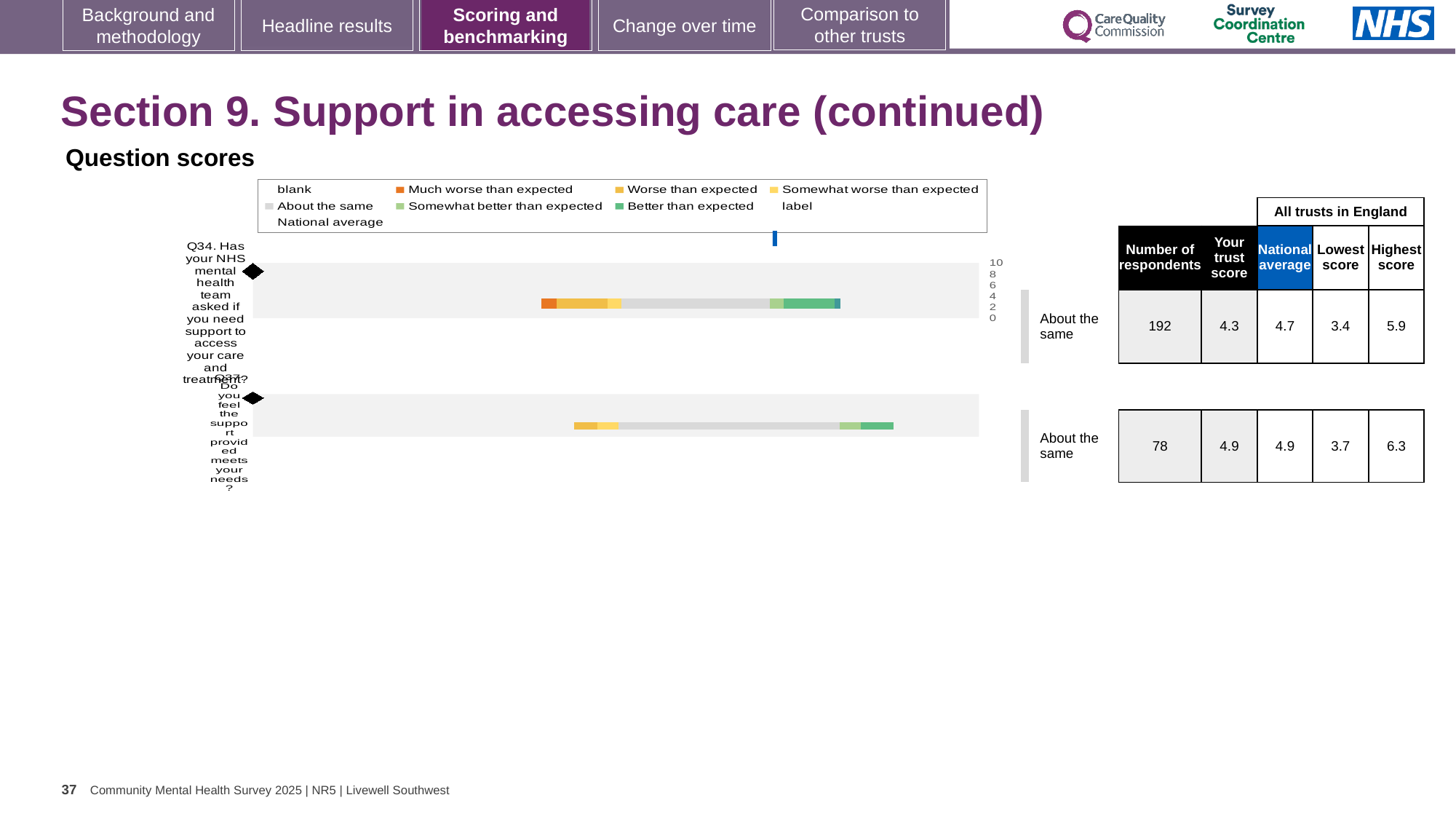
What is the number of respondents for Q34 in the question scores table? 192 What is the lowest score among all trusts in England for Q34? 3.4 How many more respondents answered Q34 than Q37? 114 What is the national average score for Q34? 4.7 How many questions are plotted in the question scores chart? 2 What is the trust's score for Q37 (Do you feel the support provided meets your needs?)? 4.9 What benchmark category is shown for Q37 in the question scores chart? About the same What kind of chart is used to show the question scores on this slide? bar chart Which question has the higher number of respondents, Q34 or Q37? Q34 What is the highest score among all trusts in England for Q37? 6.3 Which is larger for Q34: the trust's score or the national average? National average What is the difference between the highest and lowest scores for Q34? 2.5